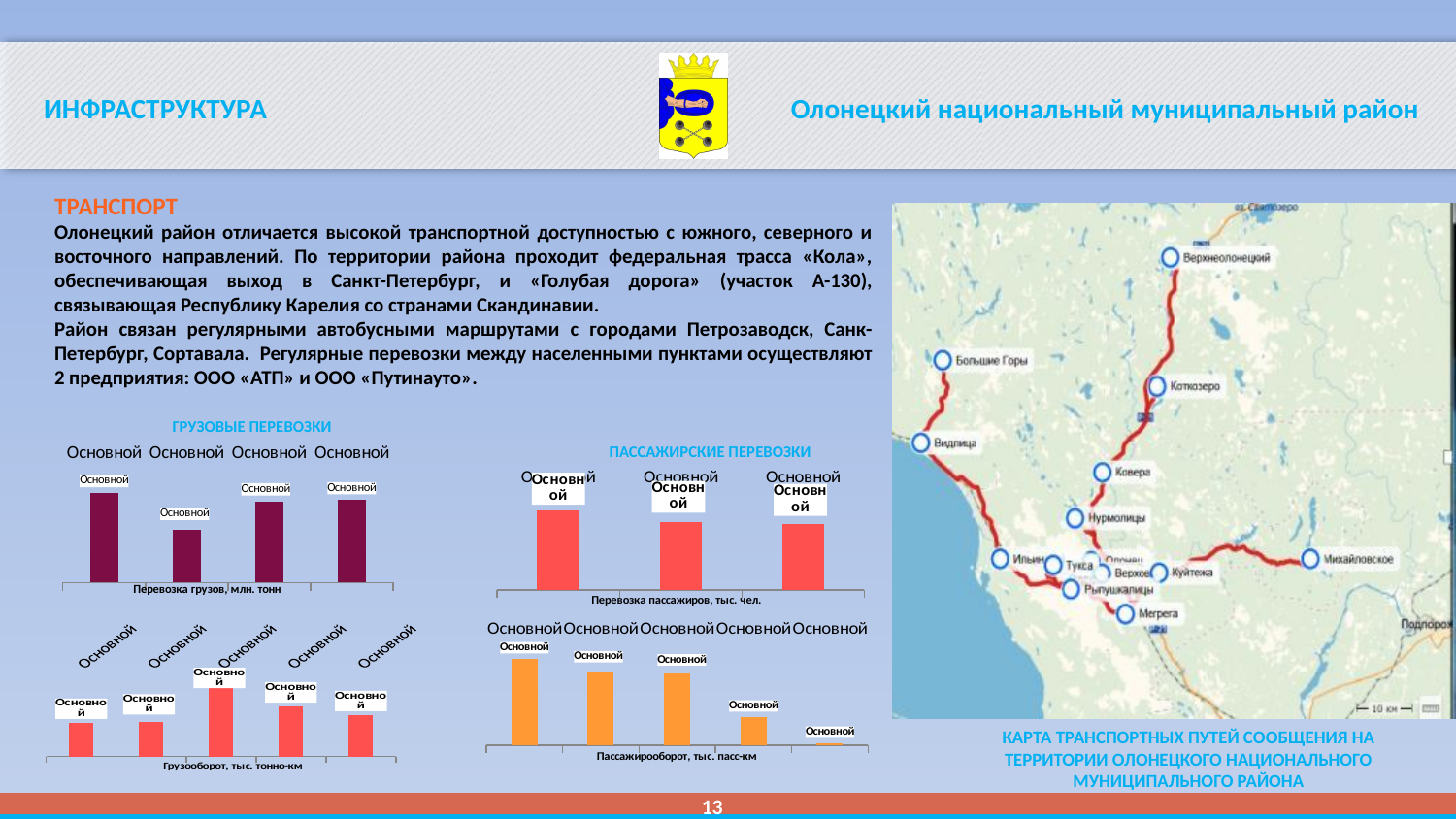
How many bars are plotted in the chart titled "Грузооборот, тыс. тонно-км"? 5 What kind of chart is the chart titled "Пассажирооборот, тыс. пасс-км"? bar chart What is the axis title of the bottom-middle chart under "ПАССАЖИРСКИЕ ПЕРЕВОЗКИ"? Пассажирооборот, тыс. пасс-км How many bars are plotted in the chart titled "Перевозка грузов, млн. тонн"? 4 How many bars are plotted in the chart titled "Перевозка пассажиров, тыс. чел."? 3 How many charts are shown under the heading "ГРУЗОВЫЕ ПЕРЕВОЗКИ"? 2 In the chart titled "Пассажирооборот, тыс. пасс-км", do the bar values rise or fall from left to right? fall What kind of chart is the chart titled "Перевозка грузов, млн. тонн"? bar chart